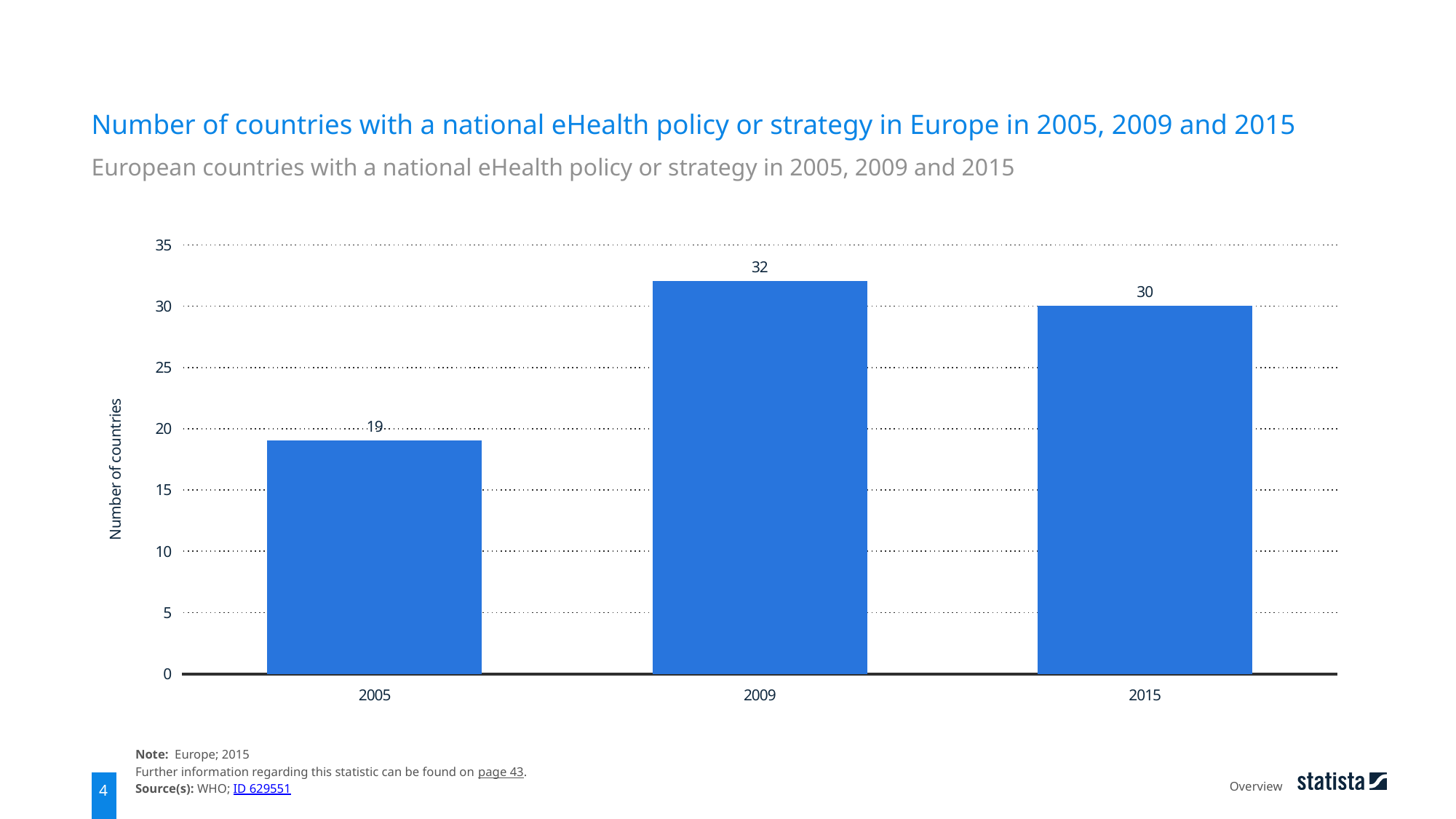
Which year has the lowest number of countries with a national eHealth policy or strategy? 2005 What is the difference between the number of countries in 2009 and in 2005? 13 What kind of chart is shown on the slide? bar chart What is the number of countries with a national eHealth policy or strategy in 2015? 30 What is the number of countries with a national eHealth policy or strategy in 2009? 32 Which year has more countries with a national eHealth policy or strategy, 2005 or 2015? 2015 How many years are shown on the x axis of the chart? 3 What is the number of countries with a national eHealth policy or strategy in 2005? 19 Is the value for 2005 greater or less than 20? less Which year has the highest number of countries with a national eHealth policy or strategy? 2009 What is the label of the y axis? Number of countries What is the difference between the number of countries in 2009 and in 2015? 2